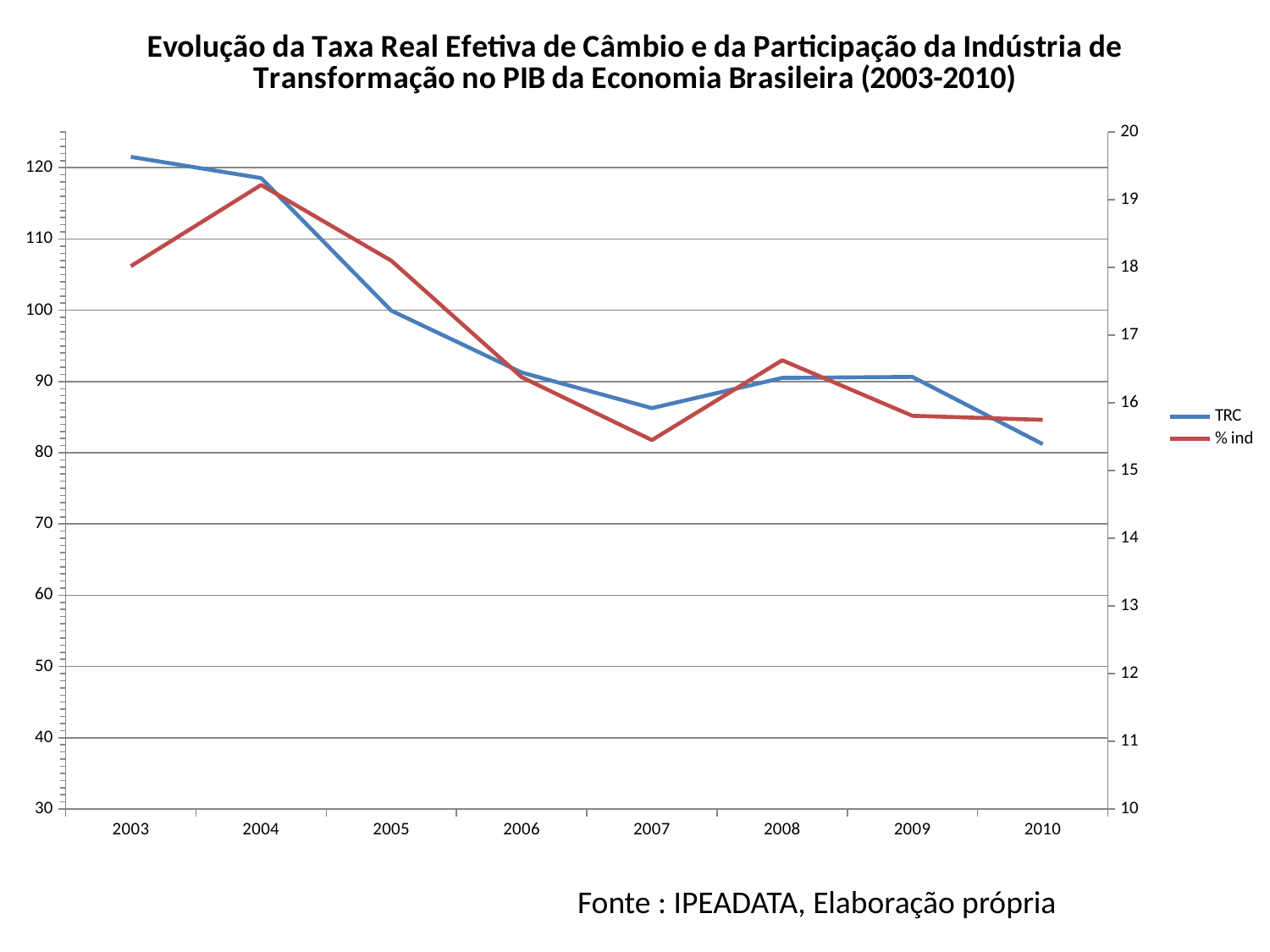
Does the TRC series overall rise or fall from 2003 to 2010? fall How many series does the legend list? 2 In which year is the % ind series at its lowest? 2007 In which year is the TRC series at its lowest? 2010 What kind of chart is shown on the slide? line chart Is the TRC value for 2003 greater or less than 120? greater Is the TRC value for 2007 greater or less than 90? less Is the % ind value for 2007 greater or less than 16? less Which series is drawn in red according to the legend? % ind In which year is the % ind series at its highest? 2004 How many years are plotted along the x axis? 8 In which year is the TRC series at its highest? 2003